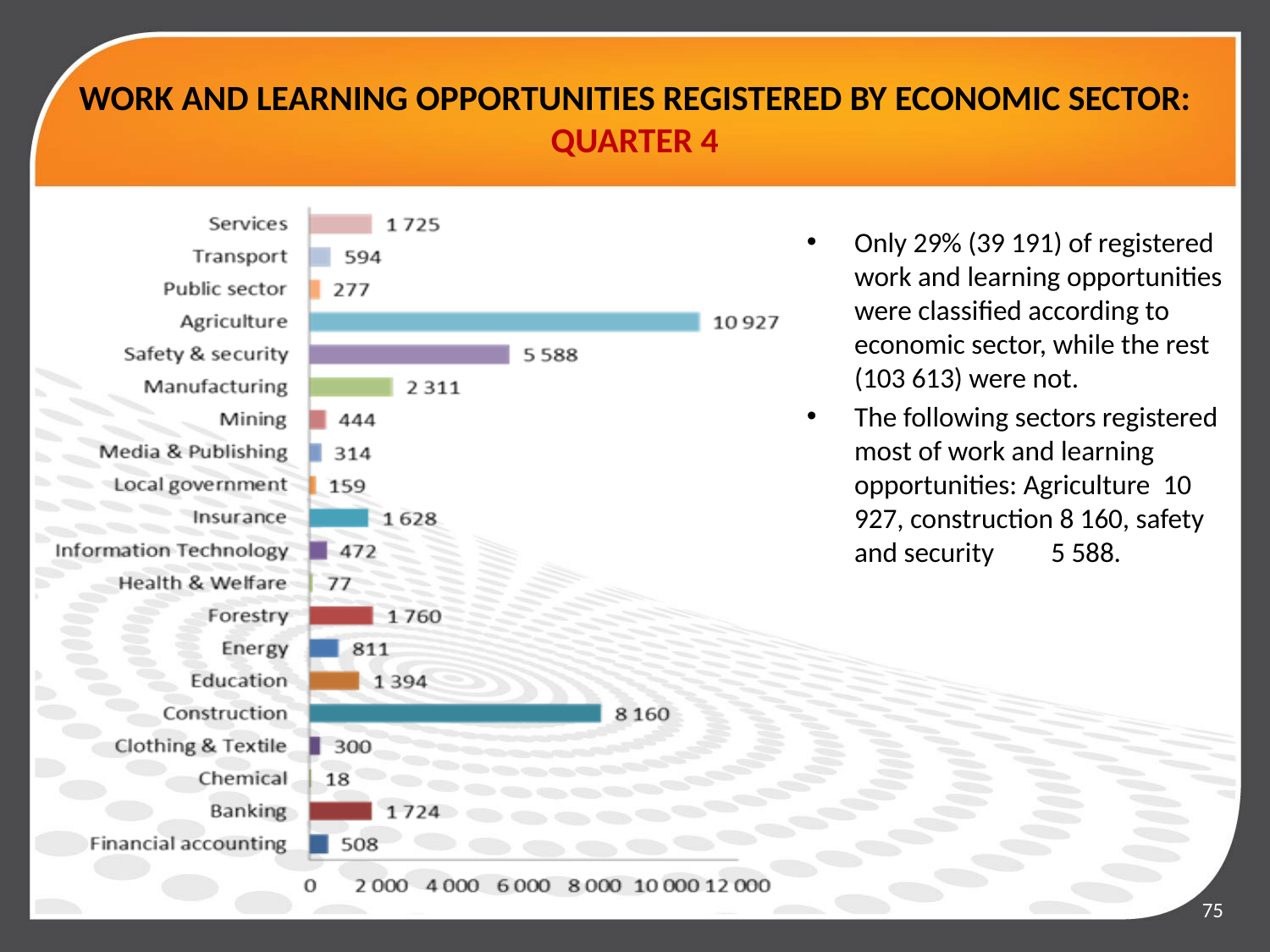
Which sector has the lowest value? Chemical What value is shown for Agriculture? 10 927 What value is shown for Education? 1 394 Is the value for Safety & security greater or less than 4 000? greater Which sector has the highest value? Agriculture What is the difference between the values for Agriculture and Construction? 2 767 What value is shown for Construction? 8 160 What kind of chart is shown on the slide? Bar chart Which is larger, the value for Manufacturing or the value for Insurance? Manufacturing What is the difference between the values for Construction and Safety & security? 2 572 What value is shown for Local government? 159 How many sectors are shown in the chart? 20